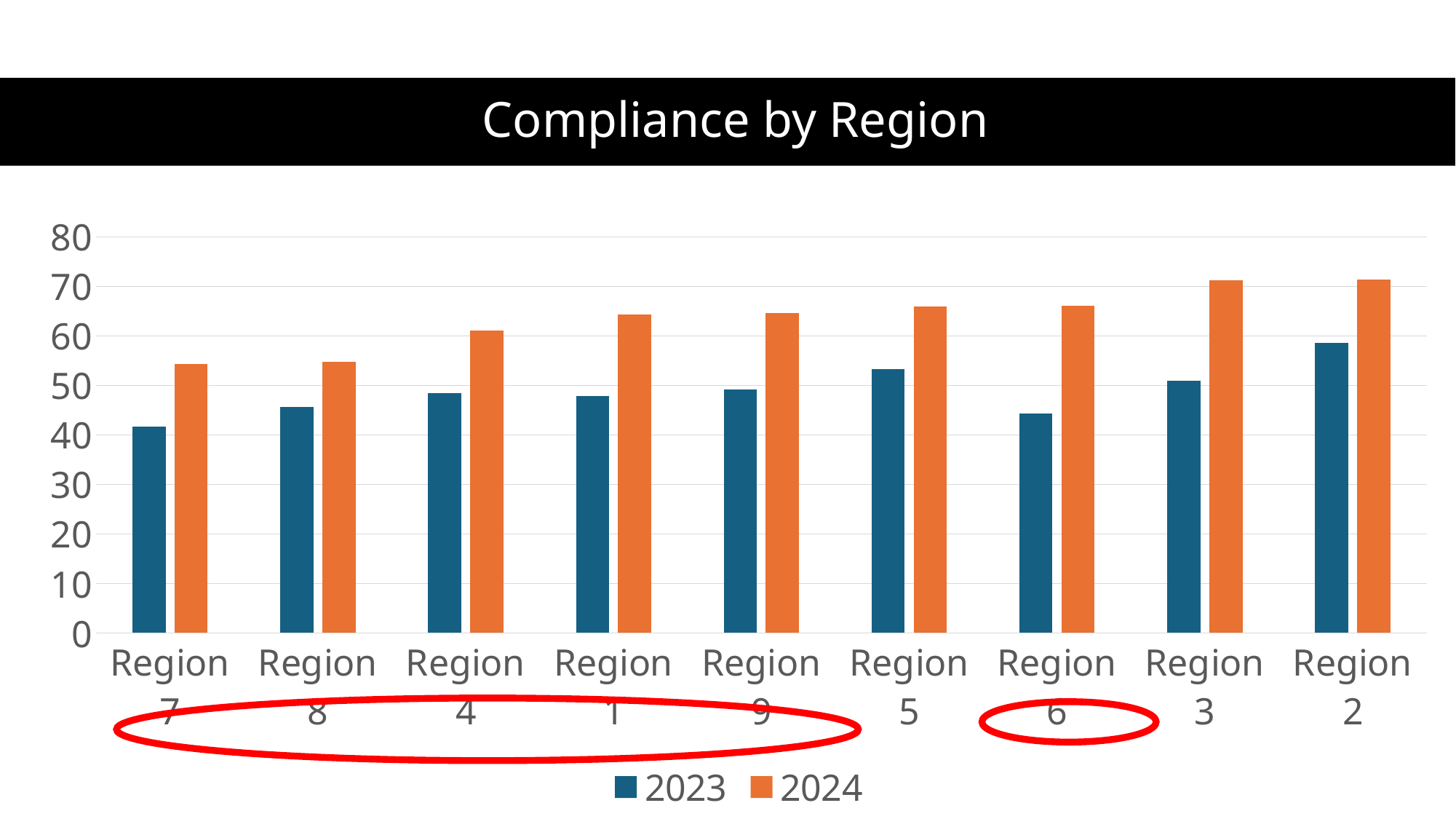
Which is larger, the 2024 value for Region 7 or the 2024 value for Region 1? Region 1 Is the 2024 value for Region 1 greater or less than 60? greater How many series does the legend list? 2 What is the title of the chart? Compliance by Region How many regions are shown on the x axis of the chart? 9 Do the 2024 values generally rise or fall from Region 7 on the left to Region 2 on the right? rise Which region has the highest 2023 value? Region 2 Which region has the lowest 2023 value? Region 7 Is the 2024 value for Region 2 greater or less than 70? greater What kind of chart is shown on the slide? bar chart Is the 2023 value for Region 8 greater or less than 50? less